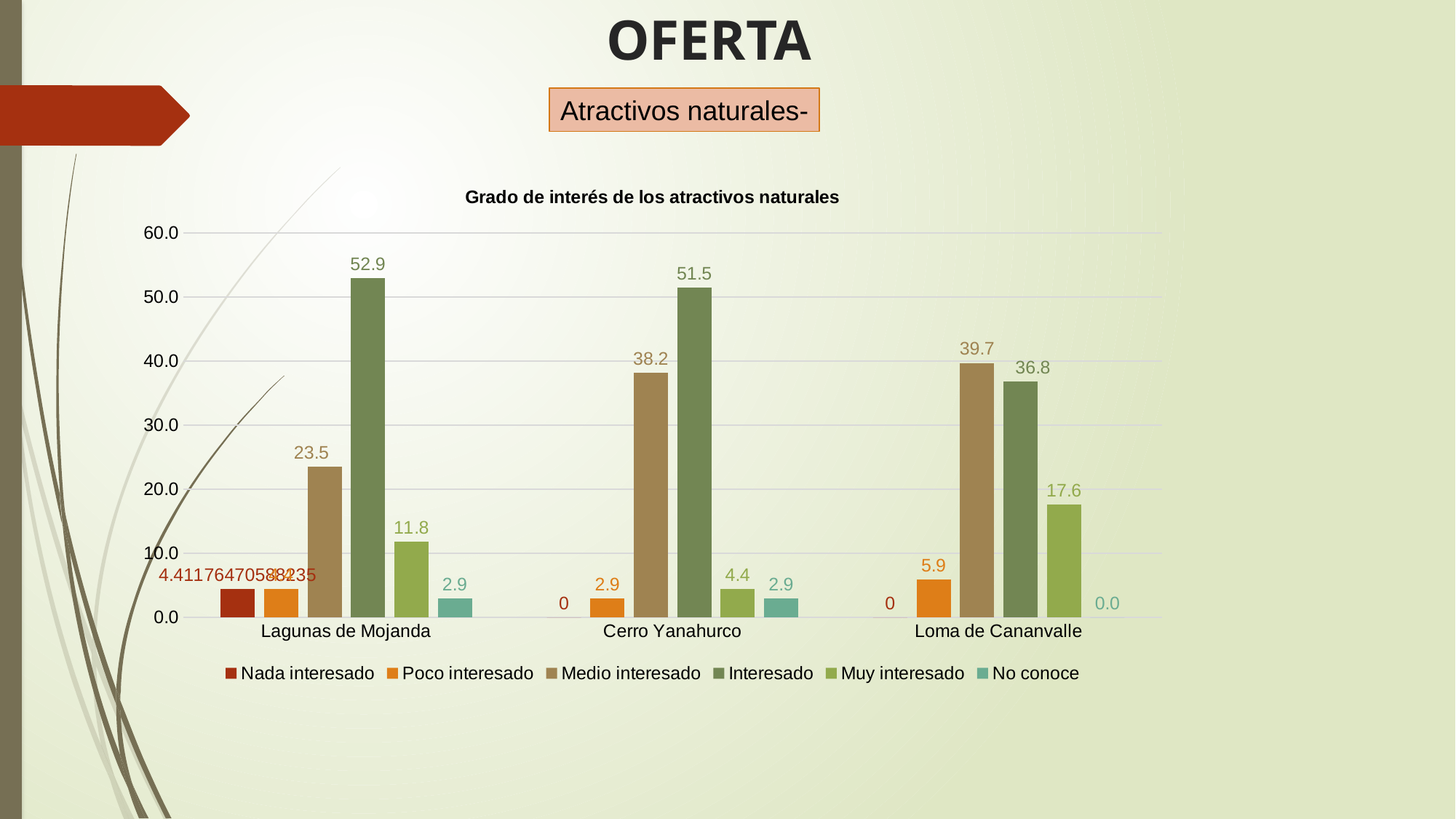
Which series has the highest value at Loma de Cananvalle? Medio interesado What is the value for Muy interesado at Loma de Cananvalle? 17.6 Which location has the highest value for Interesado? Lagunas de Mojanda How many series does the legend list? 6 What is the value for Medio interesado at Cerro Yanahurco? 38.2 What type of chart is shown? bar chart Is the value for Medio interesado at Lagunas de Mojanda greater or less than 20.0? greater What is the difference between Interesado and Medio interesado at Cerro Yanahurco? 13.3 Which is larger at Loma de Cananvalle: Medio interesado or Interesado? Medio interesado How many locations are shown on the x axis? 3 What is the value for No conoce at Loma de Cananvalle? 0.0 What is the value for Interesado at Lagunas de Mojanda? 52.9